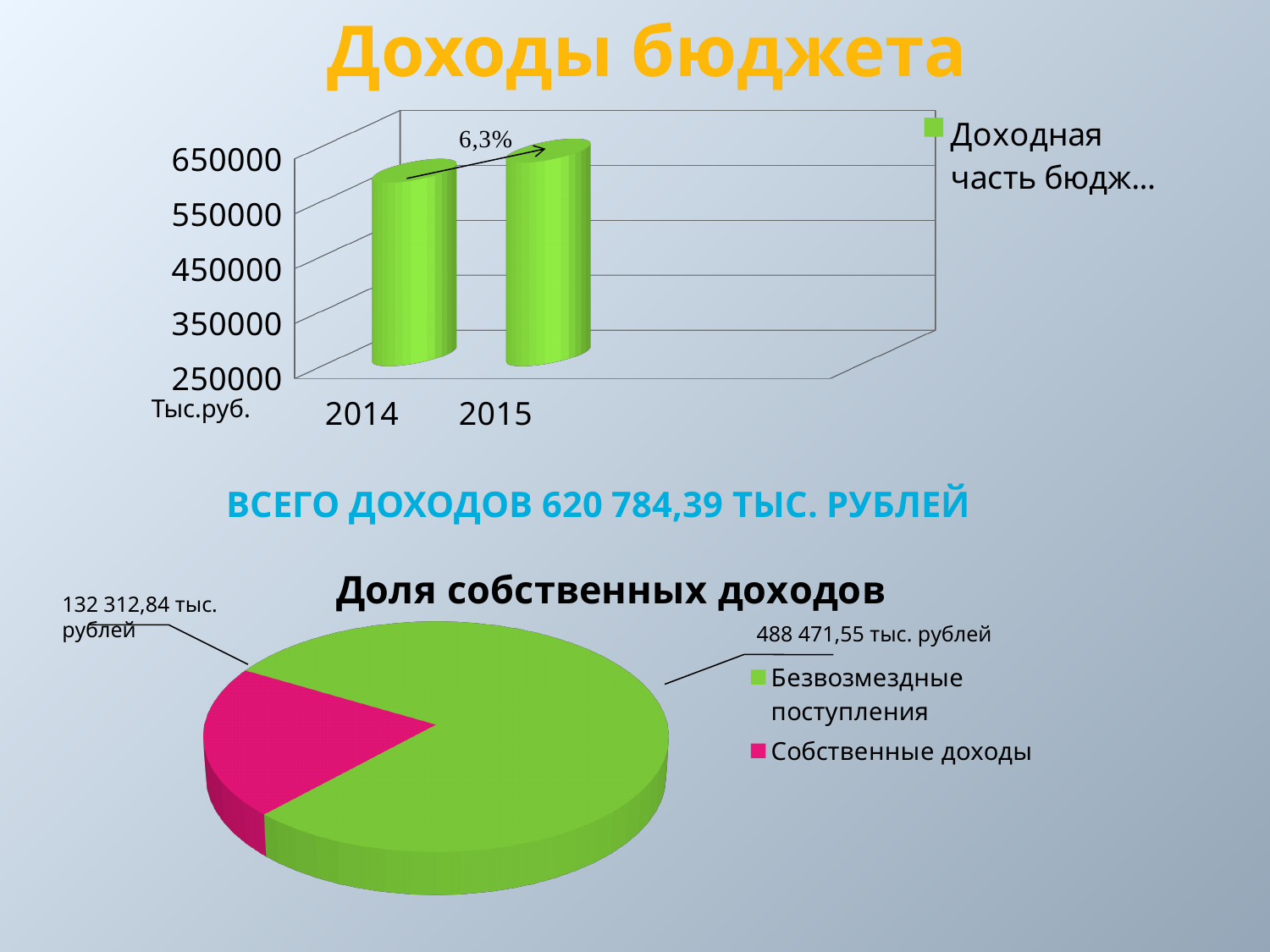
In the upper bar chart, which year has the higher value, 2014 or 2015? 2015 In the upper bar chart, is the value for 2014 greater or less than 550000? greater In the upper bar chart, what percentage change is labelled between 2014 and 2015? 6,3% In the upper bar chart, is the value for 2015 greater or less than 650000? less What type of chart is the upper chart on the slide? bar chart What type of chart is the lower chart titled 'Доля собственных доходов'? pie chart In the pie chart 'Доля собственных доходов', what is the value for Собственные доходы? 132 312,84 тыс. рублей In the pie chart 'Доля собственных доходов', what is the value for Безвозмездные поступления? 488 471,55 тыс. рублей In the upper bar chart, what unit is shown below the vertical axis? Тыс.руб. In the upper bar chart, how many categories are shown on the x axis? 2 In the pie chart 'Доля собственных доходов', which slice is the largest? Безвозмездные поступления In the pie chart 'Доля собственных доходов', how many entries does the legend list? 2